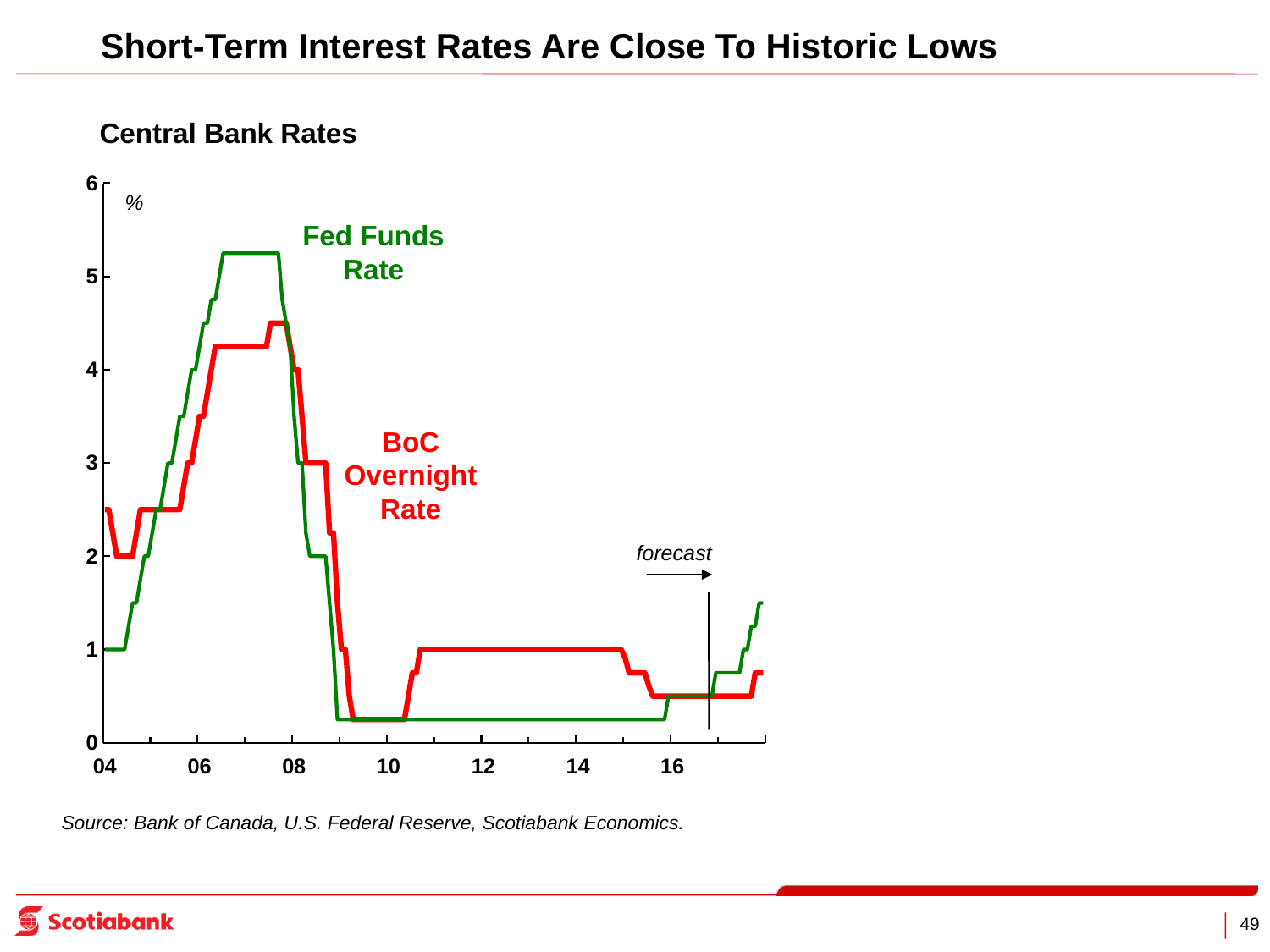
What kind of chart is shown on the slide? line chart How many series are plotted on the Central Bank Rates chart? 2 Is the peak value of the BoC Overnight Rate around 2007-08 greater or less than 4? greater Do the Fed Funds Rate values rise or fall between 2008 and 2009? fall Is the Fed Funds Rate at the start of 2004 greater or less than 2? less Is the Fed Funds Rate in 2012 greater or less than 1? less What is the title of the chart? Central Bank Rates Which series is higher in 2007, the Fed Funds Rate or the BoC Overnight Rate? Fed Funds Rate Which colour is used for the Fed Funds Rate line? green Which series is higher in 2012, the Fed Funds Rate or the BoC Overnight Rate? BoC Overnight Rate What is the BoC Overnight Rate in 2012? 1